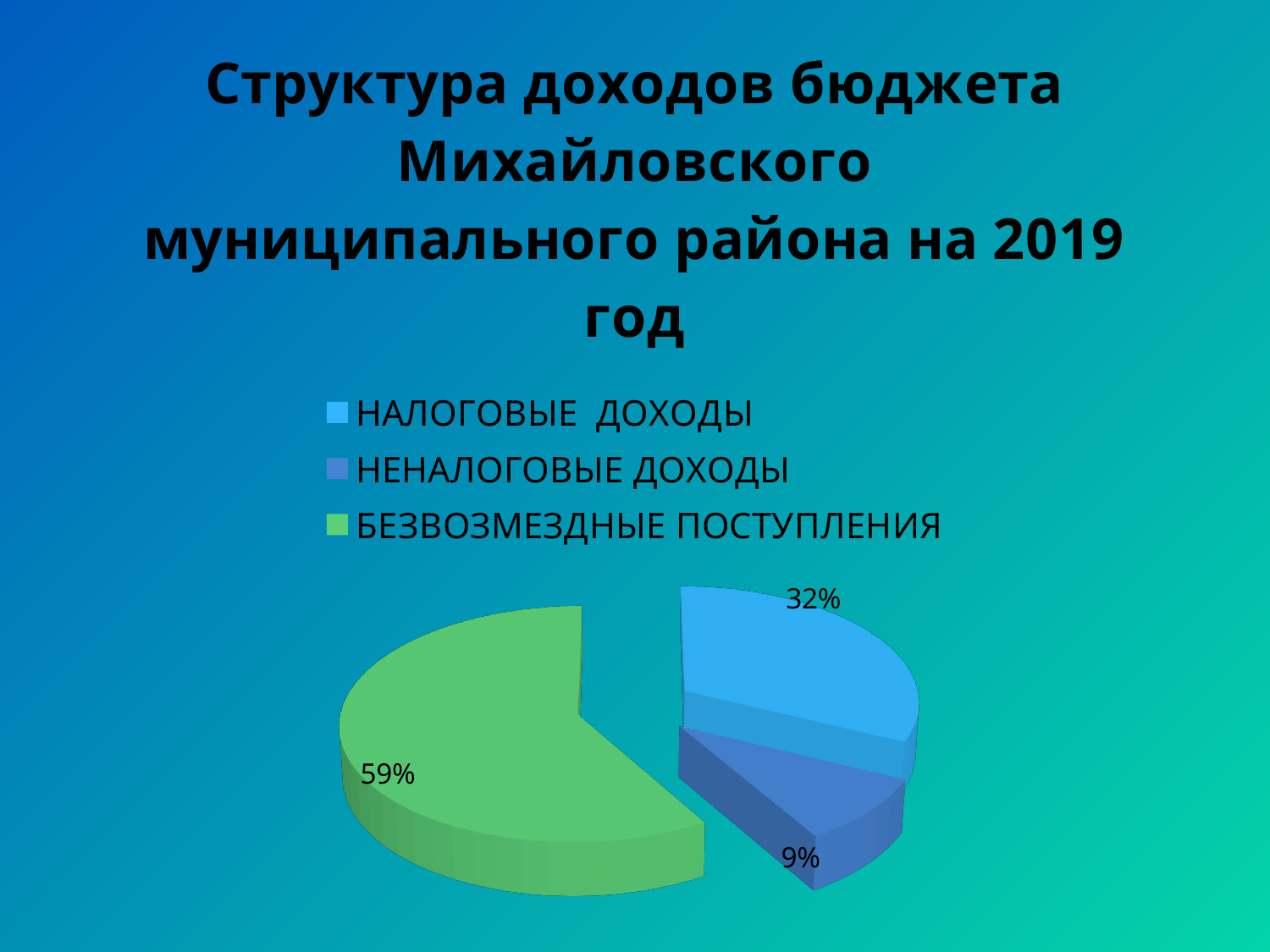
How many slices does the pie chart have? 3 What colour is the slice for БЕЗВОЗМЕЗДНЫЕ ПОСТУПЛЕНИЯ? green What share of the budget revenue is БЕЗВОЗМЕЗДНЫЕ ПОСТУПЛЕНИЯ? 59% What kind of chart is shown on the slide? pie chart Which category has the largest share of the pie? БЕЗВОЗМЕЗДНЫЕ ПОСТУПЛЕНИЯ What share of the budget revenue is НАЛОГОВЫЕ ДОХОДЫ? 32% Which is larger, the share for НАЛОГОВЫЕ ДОХОДЫ or the share for НЕНАЛОГОВЫЕ ДОХОДЫ? НАЛОГОВЫЕ ДОХОДЫ What is the difference in percentage points between НАЛОГОВЫЕ ДОХОДЫ and НЕНАЛОГОВЫЕ ДОХОДЫ? 23 Which category has the smallest share of the pie? НЕНАЛОГОВЫЕ ДОХОДЫ What share of the budget revenue is НЕНАЛОГОВЫЕ ДОХОДЫ? 9% How many entries does the legend list? 3 What is the difference in percentage points between БЕЗВОЗМЕЗДНЫЕ ПОСТУПЛЕНИЯ and НАЛОГОВЫЕ ДОХОДЫ? 27